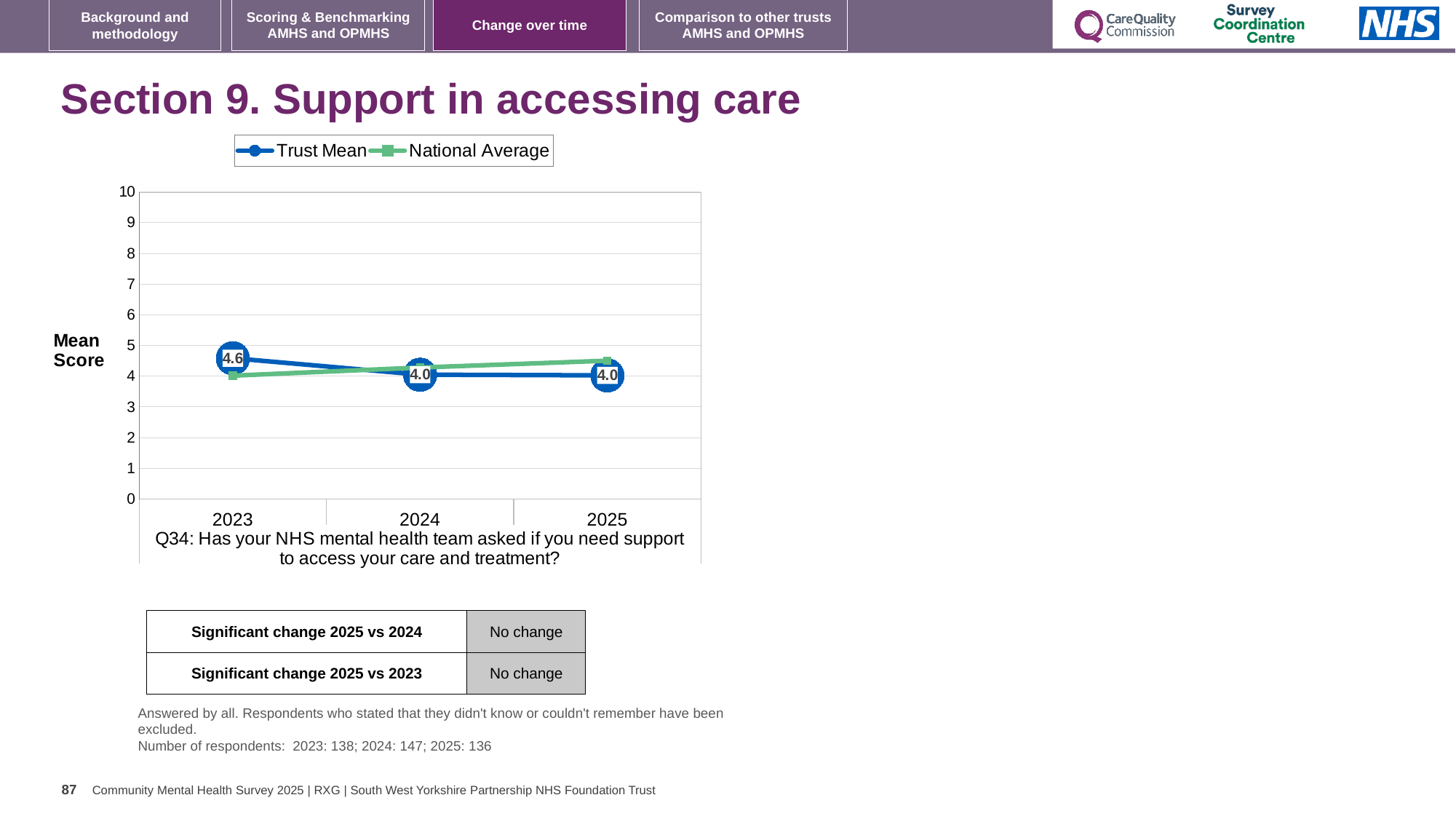
Which is larger, the Trust Mean in 2023 or the Trust Mean in 2024? 2023 In which year is the Trust Mean highest? 2023 What is the Trust Mean value for 2025? 4.0 What is the difference between the Trust Mean in 2023 and in 2024? 0.6 Is the National Average value for 2025 greater or less than 5? less In 2025, which series is higher, Trust Mean or National Average? National Average Does the Trust Mean rise or fall from 2023 to 2025? fall What kind of chart is shown on the slide? line chart How many years are plotted on the x axis? 3 What is the label on the y axis of the chart? Mean Score How many series does the legend list? 2 What is the Trust Mean value for 2023? 4.6